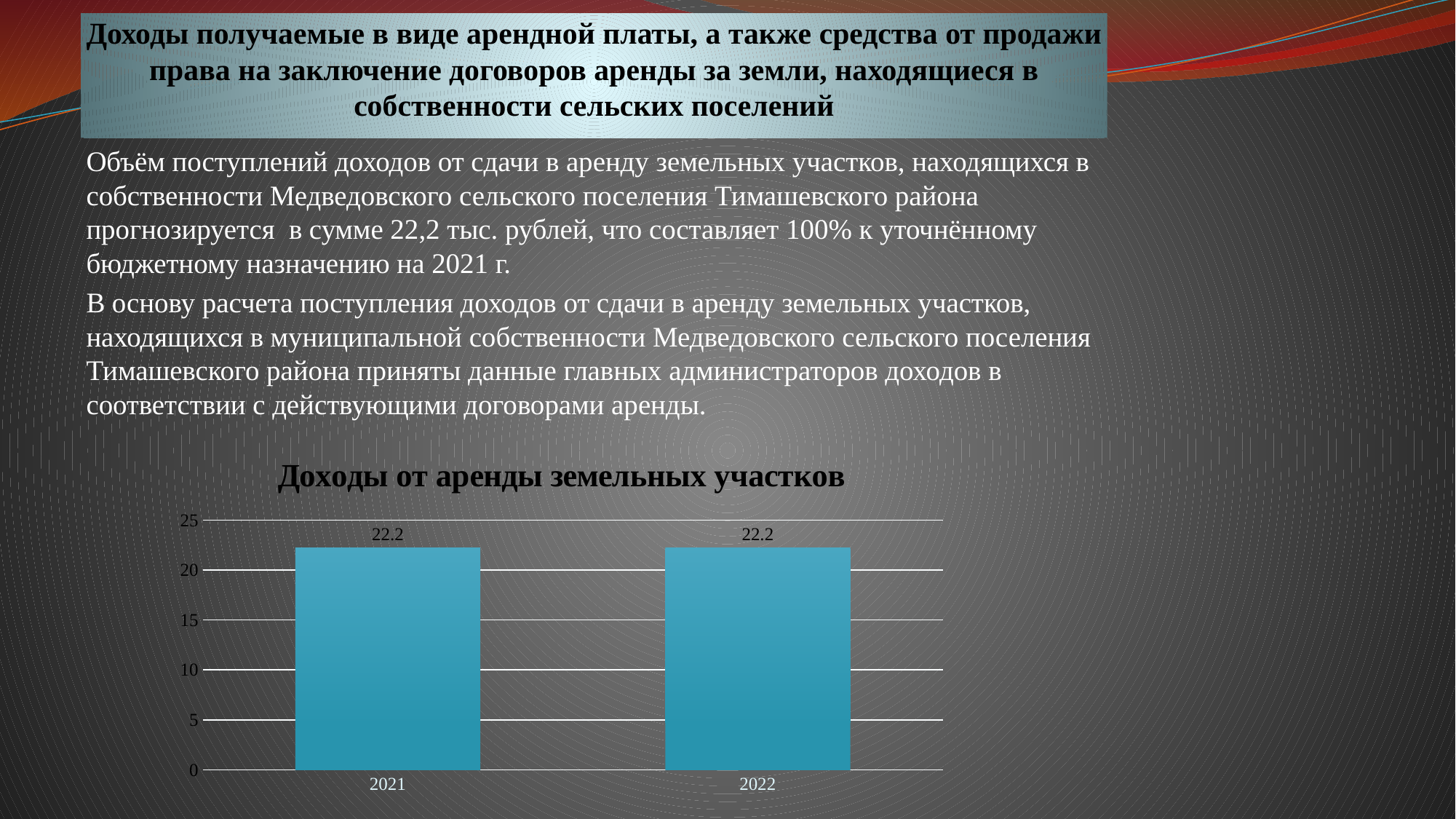
Is the value for 2022 greater or less than 25? less What kind of chart is shown on the slide? bar chart What is the value for 2021 in the chart 'Доходы от аренды земельных участков'? 22.2 Is the value for 2021 greater or less than 20? greater What is the difference between the values for 2021 and 2022 in the chart? 0 Do the values rise, fall or stay the same from 2021 to 2022? stay the same What is the value for 2022 in the chart 'Доходы от аренды земельных участков'? 22.2 What is the title of the chart on the slide? Доходы от аренды земельных участков How many categories are shown on the x axis of the chart? 2 What is the highest value shown on the vertical axis of the chart? 25